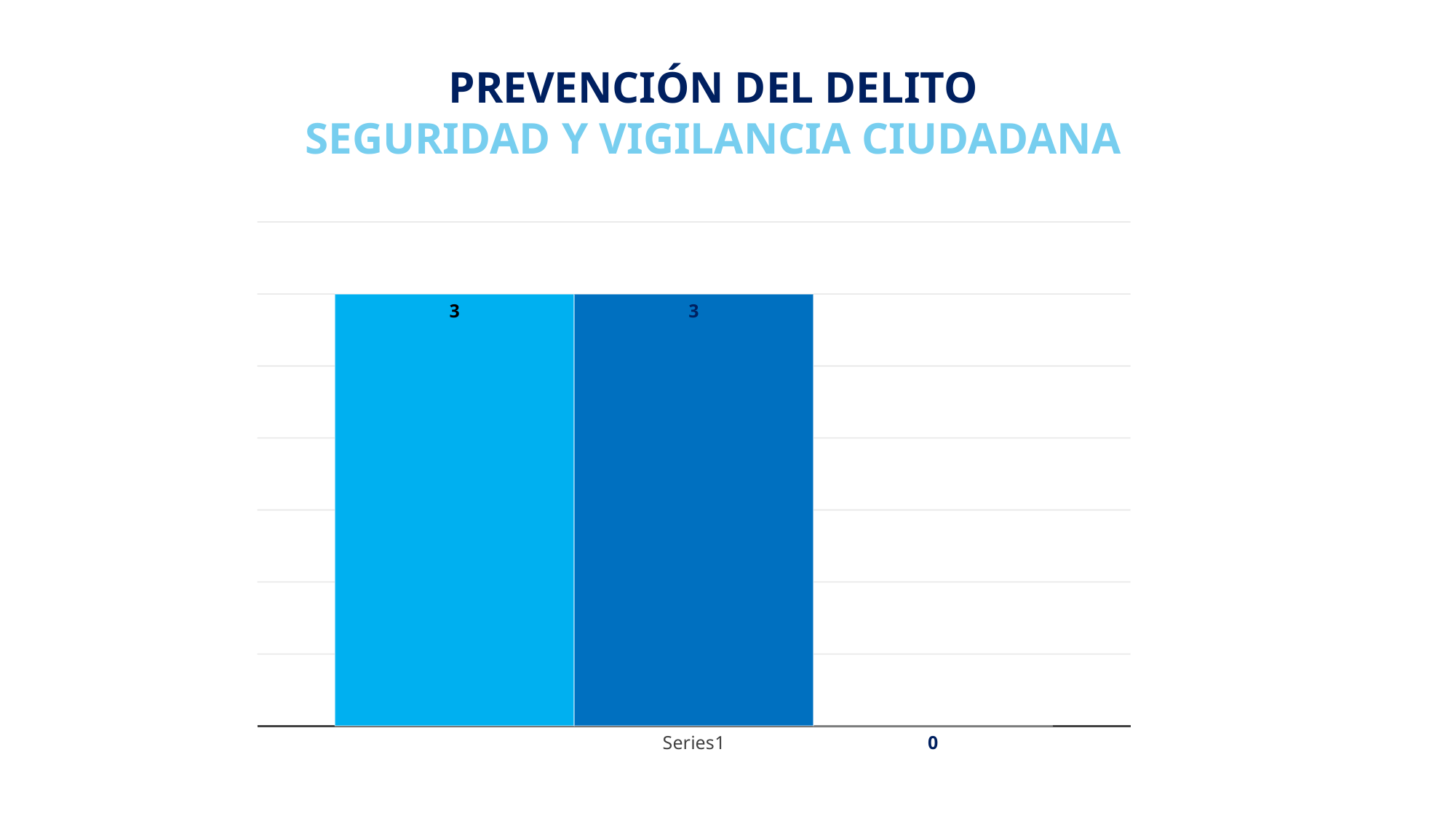
What is the value printed on the dark blue bar? 3 What is the second line of the chart title, shown in light blue? SEGURIDAD Y VIGILANCIA CIUDADANA What is the difference between the value of the light blue bar and the value of the dark blue bar? 0 Which is the lowest value printed on the chart? 0 What is the value of the third data label, shown at the right of the category axis? 0 Is the value of the light blue bar greater or less than 0? greater What is the value printed on the light blue bar? 3 What kind of chart is shown on the slide? bar chart What is the only category label shown on the horizontal axis? Series1 How many data labels are printed on the chart? 3